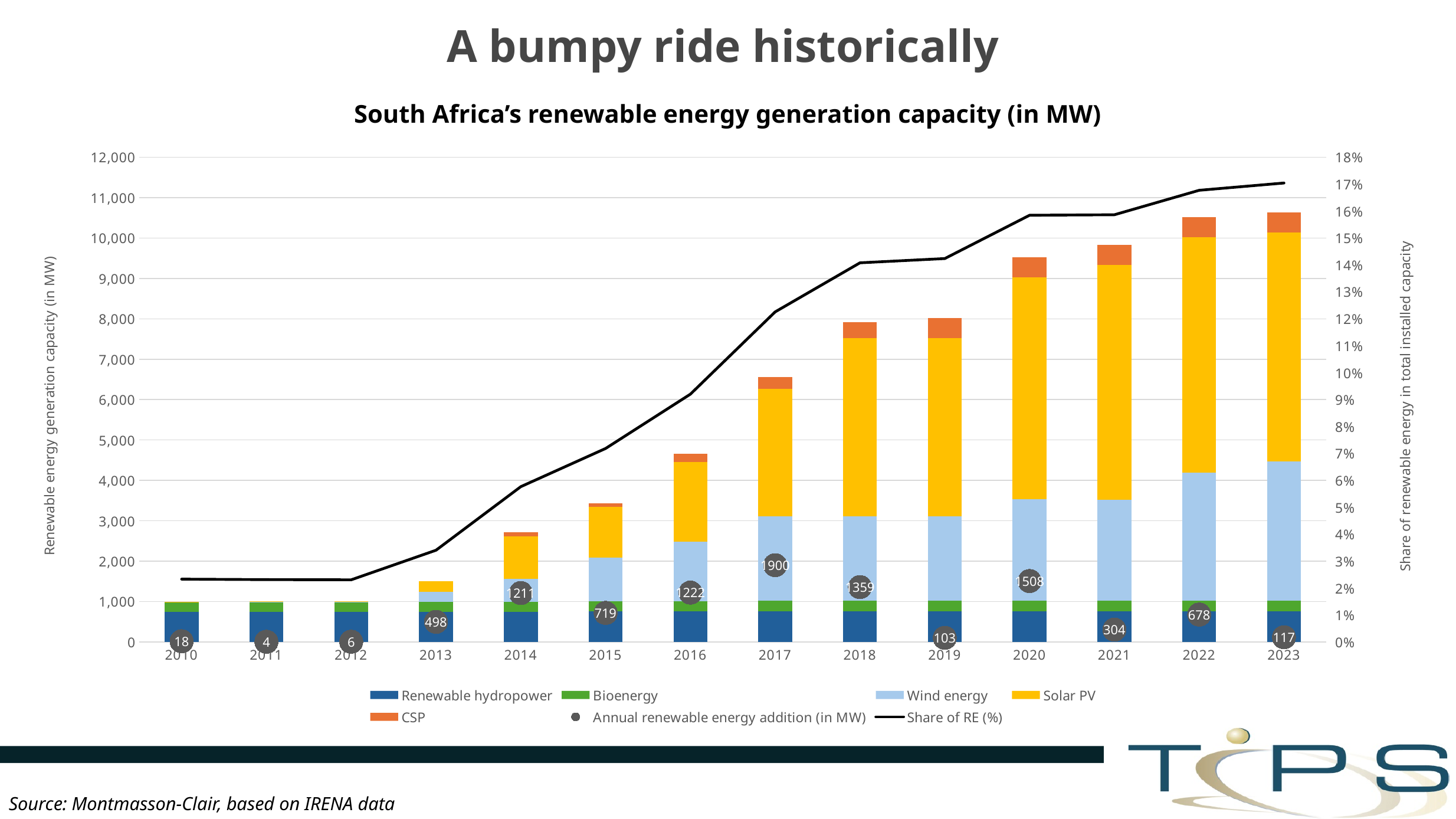
What is the annual renewable energy addition (in MW) shown for 2017? 1900 Which year has the lowest annual renewable energy addition? 2011 Which year has the highest annual renewable energy addition? 2017 How many years are shown on the x axis? 14 Is the total renewable energy generation capacity for 2023 greater or less than 10,000 MW? greater How many entries does the legend list? 7 Which year has the larger annual renewable energy addition, 2014 or 2016? 2016 Does the share of RE (%) line rise or fall from 2010 to 2023? rises Is the share of RE (%) for 2023 greater or less than 16%? greater What is the difference between the annual renewable energy addition in 2017 and in 2018? 541 What is the annual renewable energy addition (in MW) shown for 2011? 4 What kind of chart is this? Stacked bar chart with a line